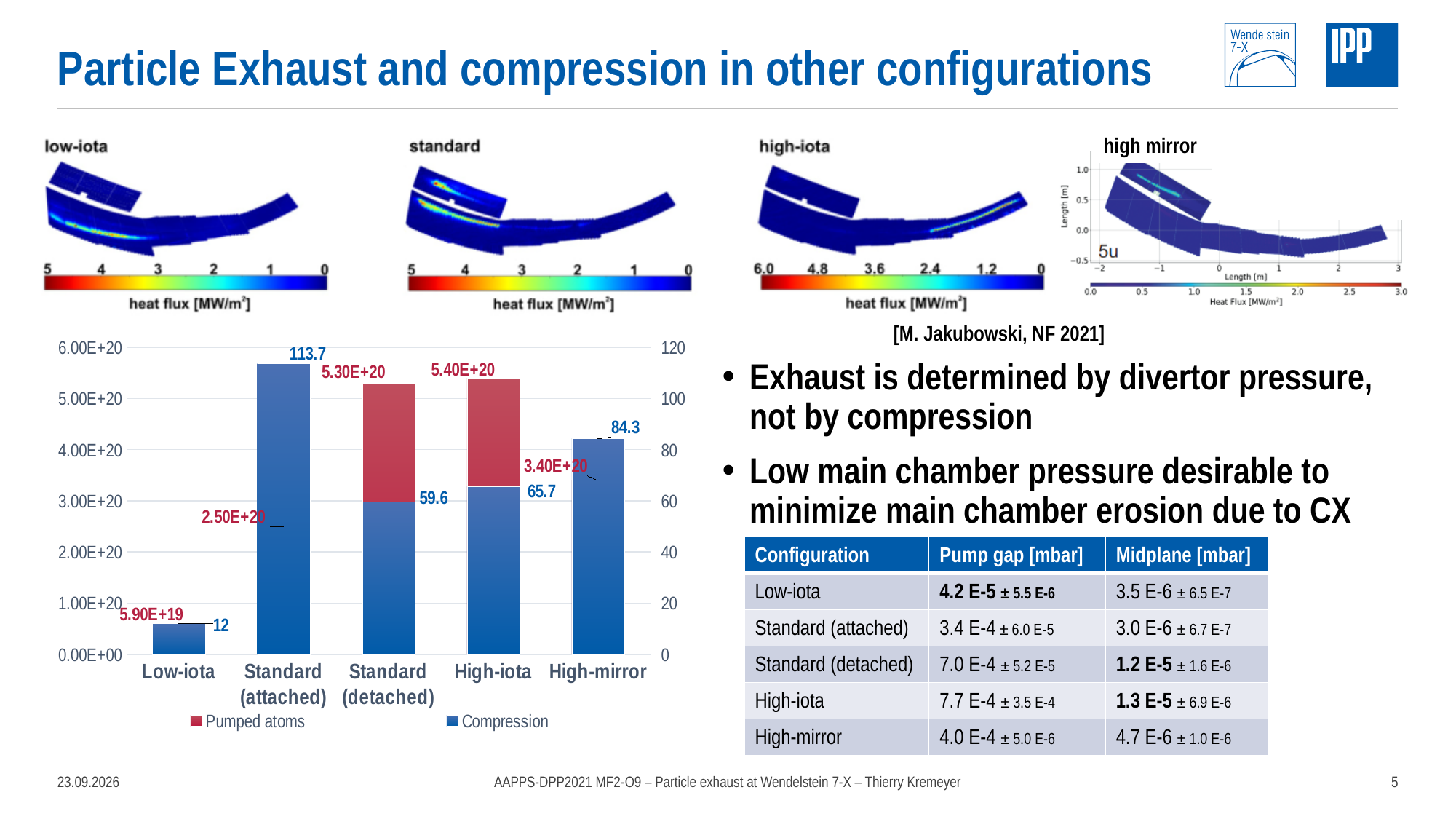
What is the Pumped atoms value for High-iota? 5.40E+20 What is the Pumped atoms value for Low-iota? 5.90E+19 Which configuration has the lowest Compression value? Low-iota Which configuration has the lowest Pumped atoms value? Low-iota Which configuration has the highest Compression value? Standard (attached) What is the Compression value for Standard (attached)? 113.7 How many series does the bar chart's legend list? 2 What is the Compression value for High-mirror? 84.3 What is the difference in Compression between Standard (attached) and High-mirror? 29.4 Which has a larger Pumped atoms value, Standard (attached) or High-mirror? High-mirror How many configurations are shown on the x axis of the bar chart? 5 What type of chart is used to show Pumped atoms and Compression? Bar chart